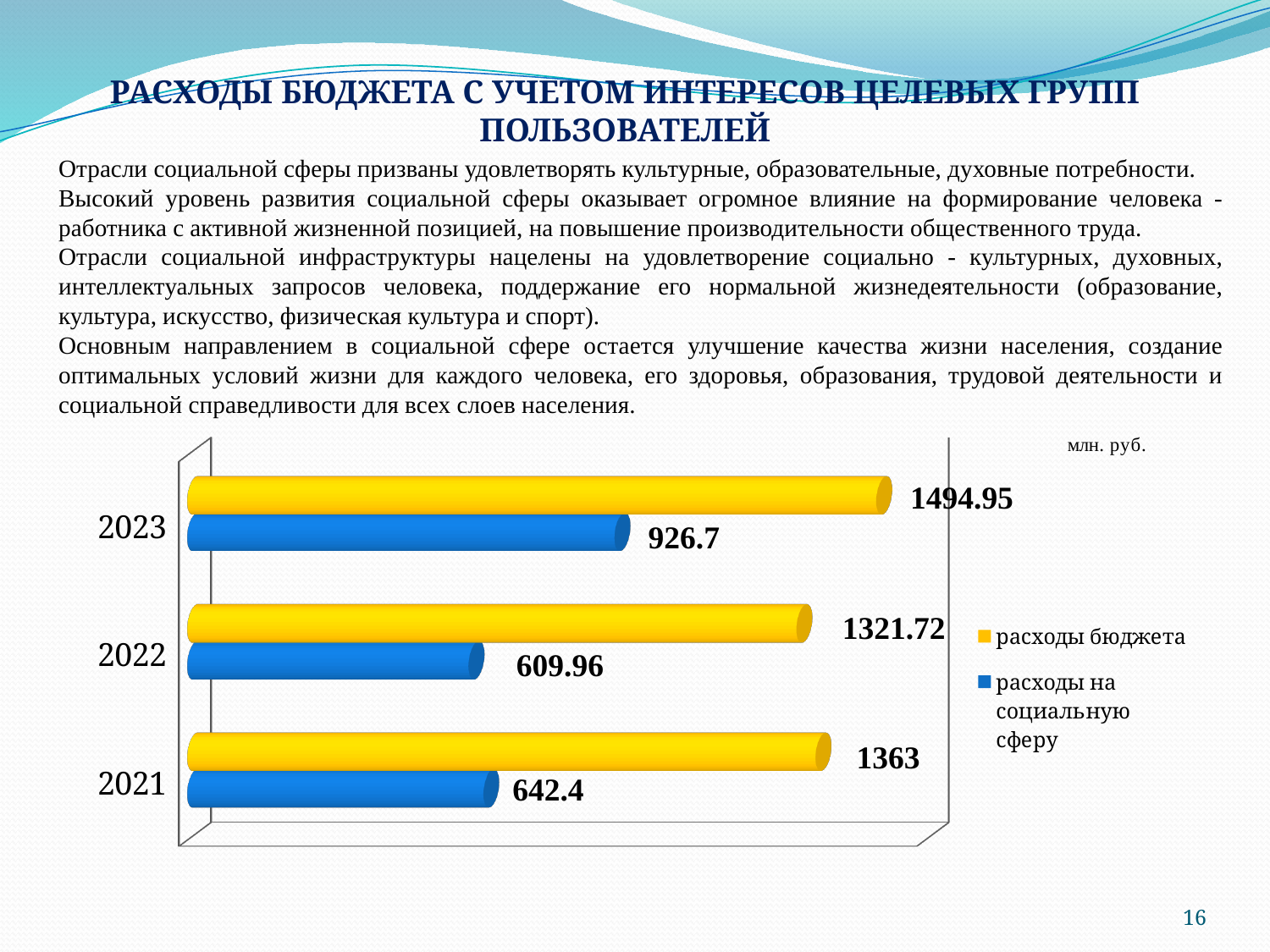
By how much did расходы на социальную сферу in 2023 exceed that in 2022? 316.74 How many years are shown on the chart? 3 How many series does the legend list? 2 What type of chart is shown on the slide? Bar chart Which is larger: расходы бюджета in 2021 or in 2022? 2021 What is the value of расходы на социальную сферу for 2022? 609.96 In which year is расходы на социальную сферу the lowest? 2022 What is the difference between расходы бюджета and расходы на социальную сферу in 2023? 568.25 What is the value of расходы на социальную сферу for 2021? 642.4 What is the value of расходы бюджета for 2023? 1494.95 In which year is расходы бюджета the highest? 2023 What is the value of расходы бюджета for 2021? 1363